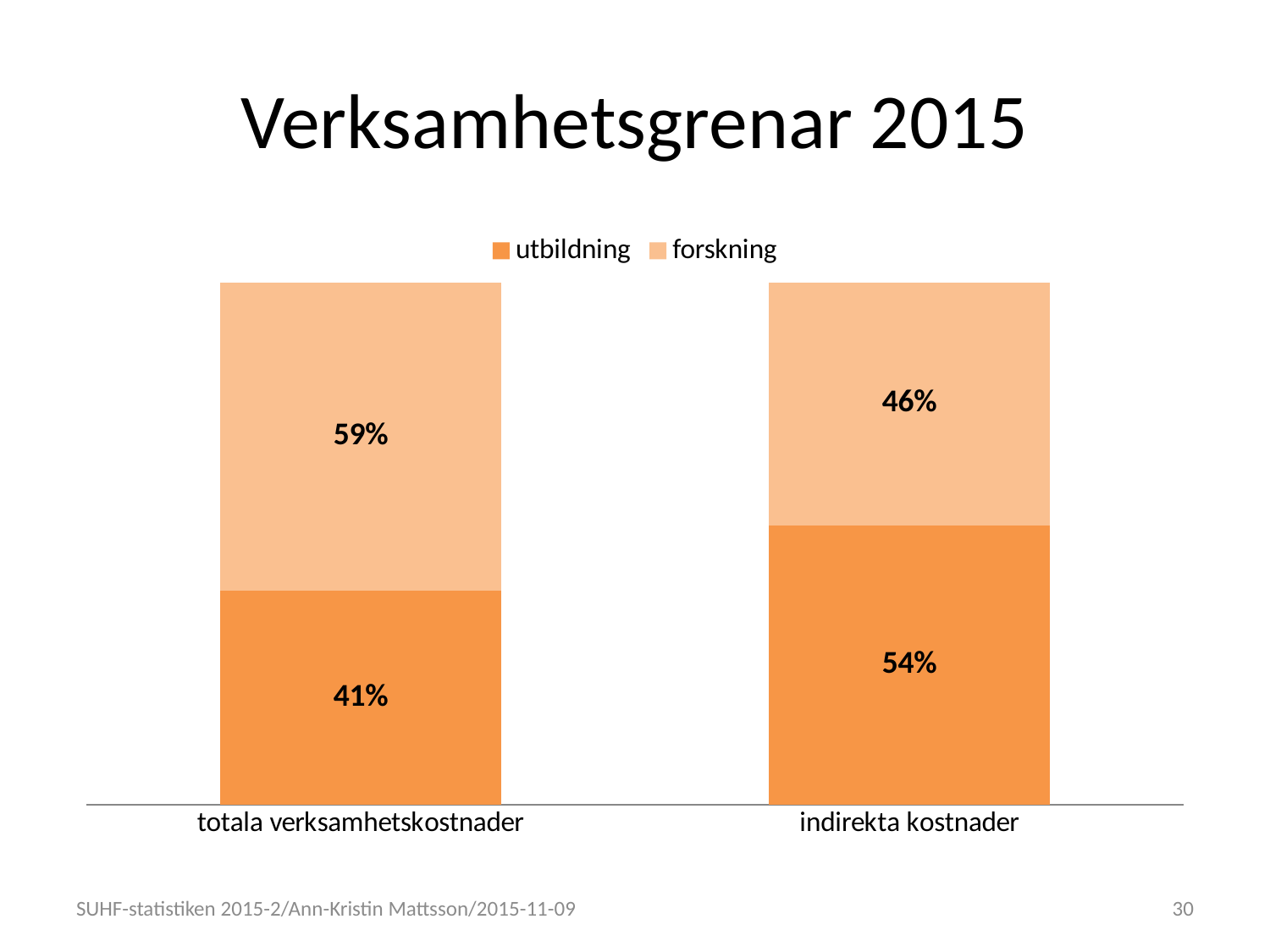
How many series does the legend list? 2 What is the value for utbildning in the indirekta kostnader bar? 54% Which category has the higher value for utbildning? indirekta kostnader What is the value for forskning in the totala verksamhetskostnader bar? 59% What is the title of the slide? Verksamhetsgrenar 2015 How many categories are shown on the x axis? 2 Which category has the higher value for forskning? totala verksamhetskostnader What is the value for utbildning in the totala verksamhetskostnader bar? 41% What is the difference between the forskning and utbildning values in the totala verksamhetskostnader bar? 18% What kind of chart is shown on the slide? stacked bar chart What is the difference between the utbildning values for indirekta kostnader and totala verksamhetskostnader? 13% What is the value for forskning in the indirekta kostnader bar? 46%